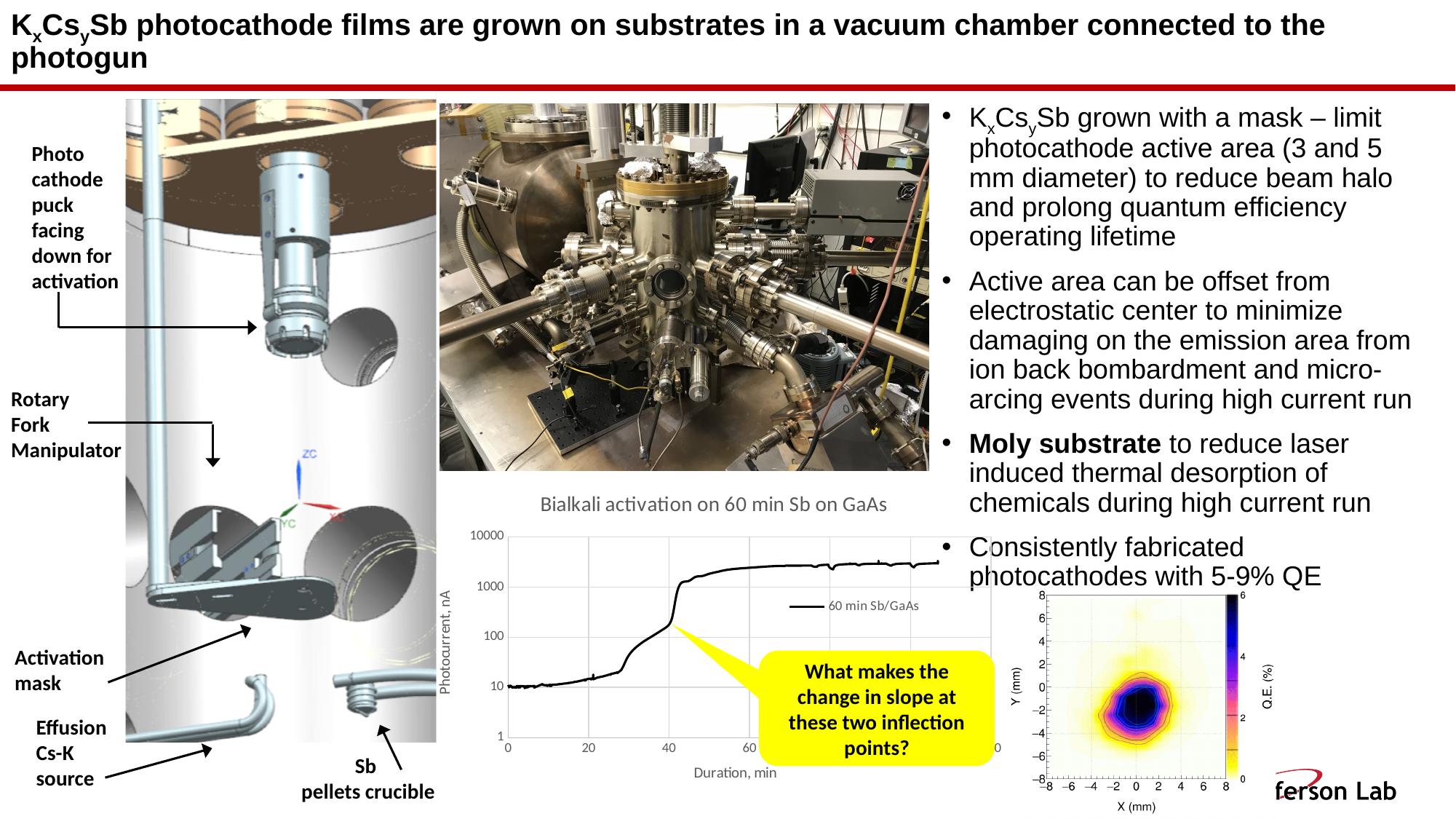
What is the legend entry in the 'Bialkali activation on 60 min Sb on GaAs' chart? 60 min Sb/GaAs How many series does the legend of the 'Bialkali activation on 60 min Sb on GaAs' chart list? 1 In the 'Bialkali activation on 60 min Sb on GaAs' chart, is the photocurrent at 60 min greater or less than 10000 nA? less What is the highest tick value shown on the y axis of the 'Bialkali activation on 60 min Sb on GaAs' chart? 10000 In the 'Bialkali activation on 60 min Sb on GaAs' chart, is the photocurrent at 40 min greater or less than 100 nA? greater In the 'Bialkali activation on 60 min Sb on GaAs' chart, is the photocurrent at 0 min greater or less than 100 nA? less In the 'Bialkali activation on 60 min Sb on GaAs' chart, does the photocurrent rise or fall as duration increases? rise What kind of chart is the 'Bialkali activation on 60 min Sb on GaAs' chart? line chart In the 'Bialkali activation on 60 min Sb on GaAs' chart, which is larger: the photocurrent at 20 min or at 60 min? 60 min What is the title of the line chart at the bottom centre of the slide? Bialkali activation on 60 min Sb on GaAs